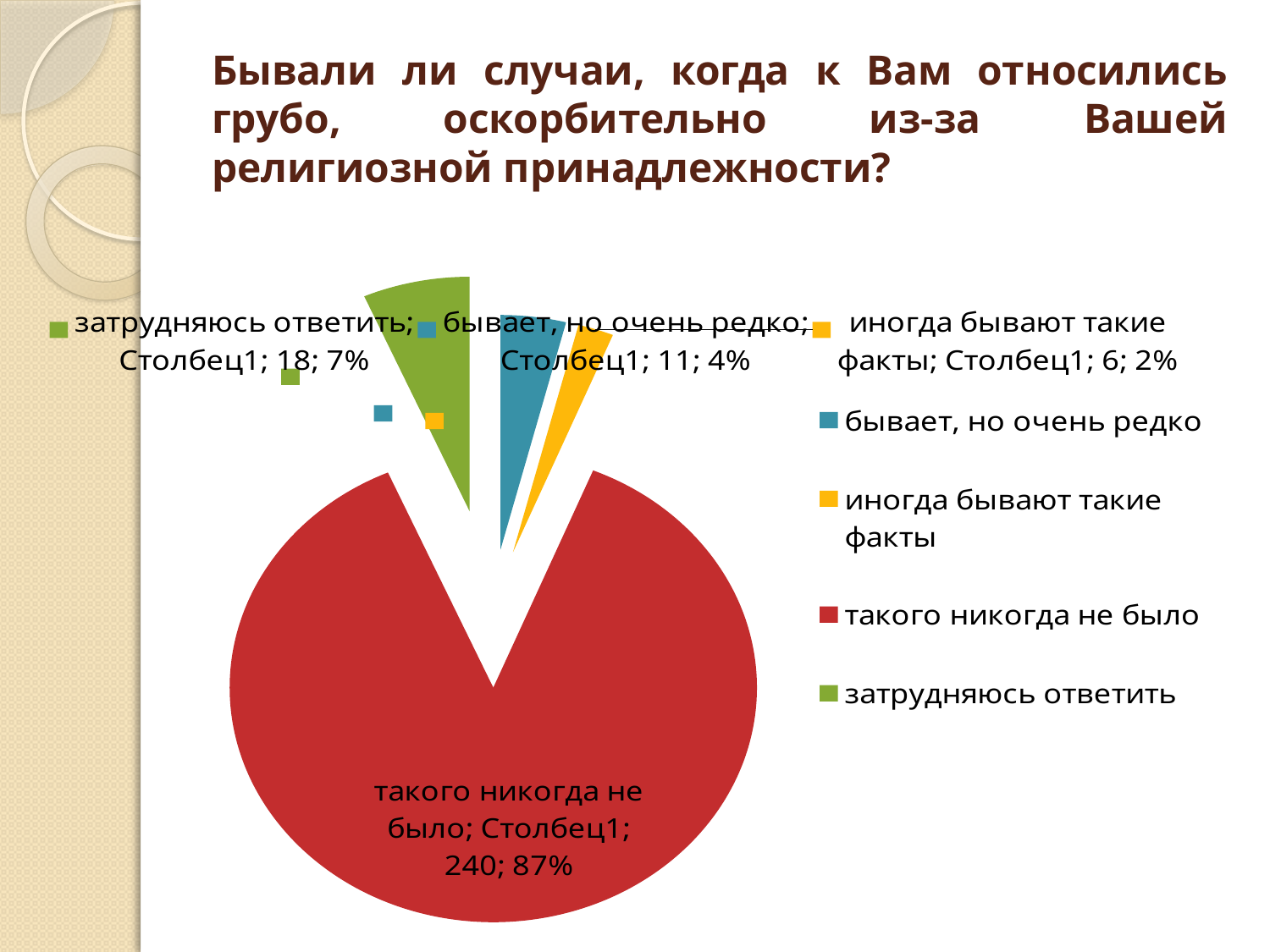
What percentage share does "бывает, но очень редко" have? 4% How many slices does the pie chart have? 4 What is the value for "иногда бывают такие факты"? 6 What is the value for "затрудняюсь ответить"? 18 What is the value for "такого никогда не было"? 240 Which category has the largest slice? такого никогда не было What is the difference between the values for "затрудняюсь ответить" and "бывает, но очень редко"? 7 Which category has the smallest slice? иногда бывают такие факты What percentage share does "такого никогда не было" have? 87% Which is larger, the value for "затрудняюсь ответить" or for "иногда бывают такие факты"? затрудняюсь ответить How many entries does the legend list? 4 What kind of chart is shown on the slide? pie chart